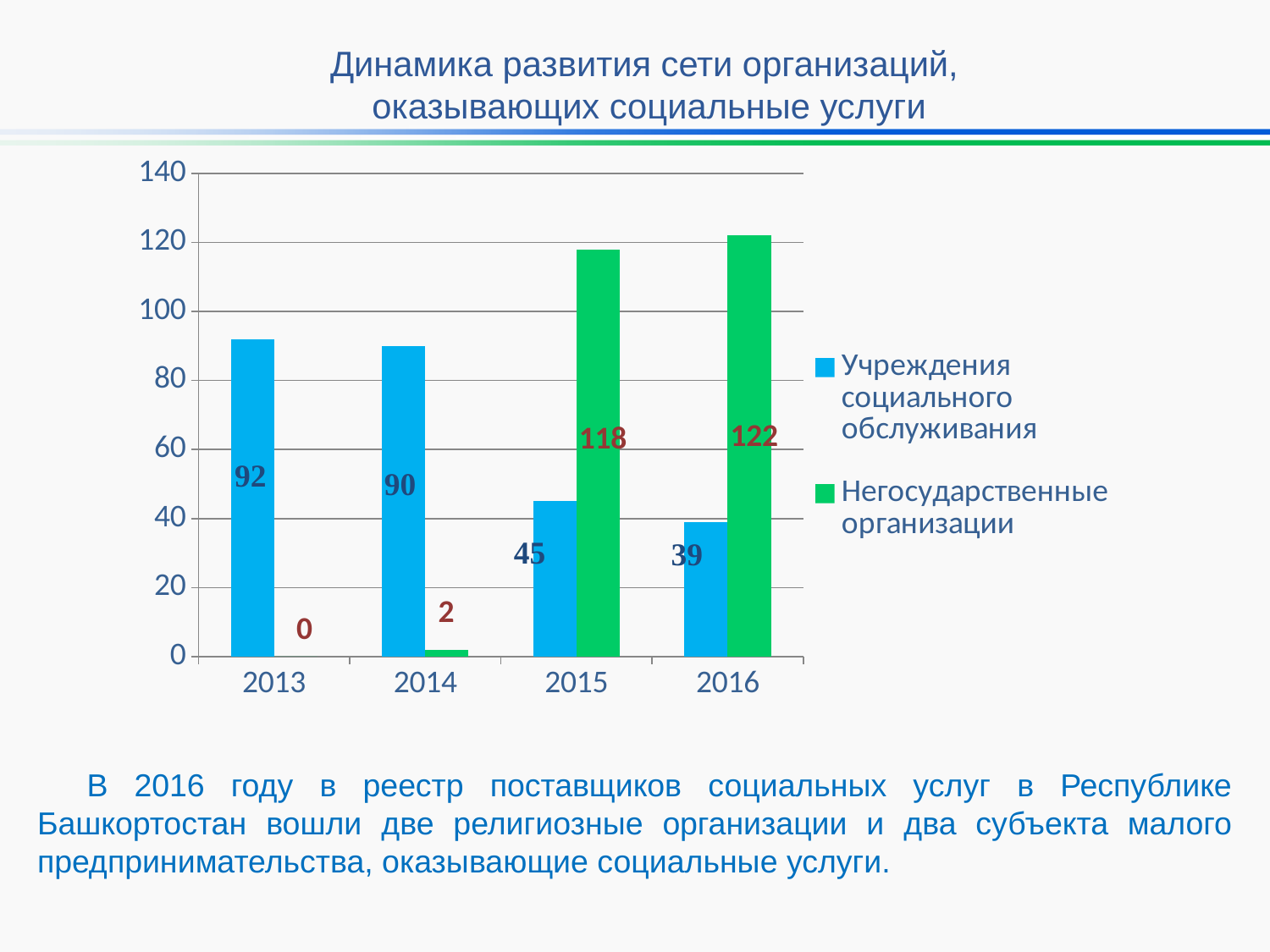
What kind of chart is shown on the slide? bar chart What is the value for Негосударственные организации in 2014? 2 What is the value for Учреждения социального обслуживания in 2013? 92 What is the value for Учреждения социального обслуживания in 2016? 39 In which year is the value for Негосударственные организации highest? 2016 Does the value for Учреждения социального обслуживания rise or fall from 2013 to 2016? fall Which is larger in 2014: Учреждения социального обслуживания or Негосударственные организации? Учреждения социального обслуживания How many years are shown on the x axis? 4 How many series does the legend list? 2 What is the difference between Негосударственные организации and Учреждения социального обслуживания in 2015? 73 In which year is the value for Учреждения социального обслуживания lowest? 2016 What is the value for Негосударственные организации in 2016? 122